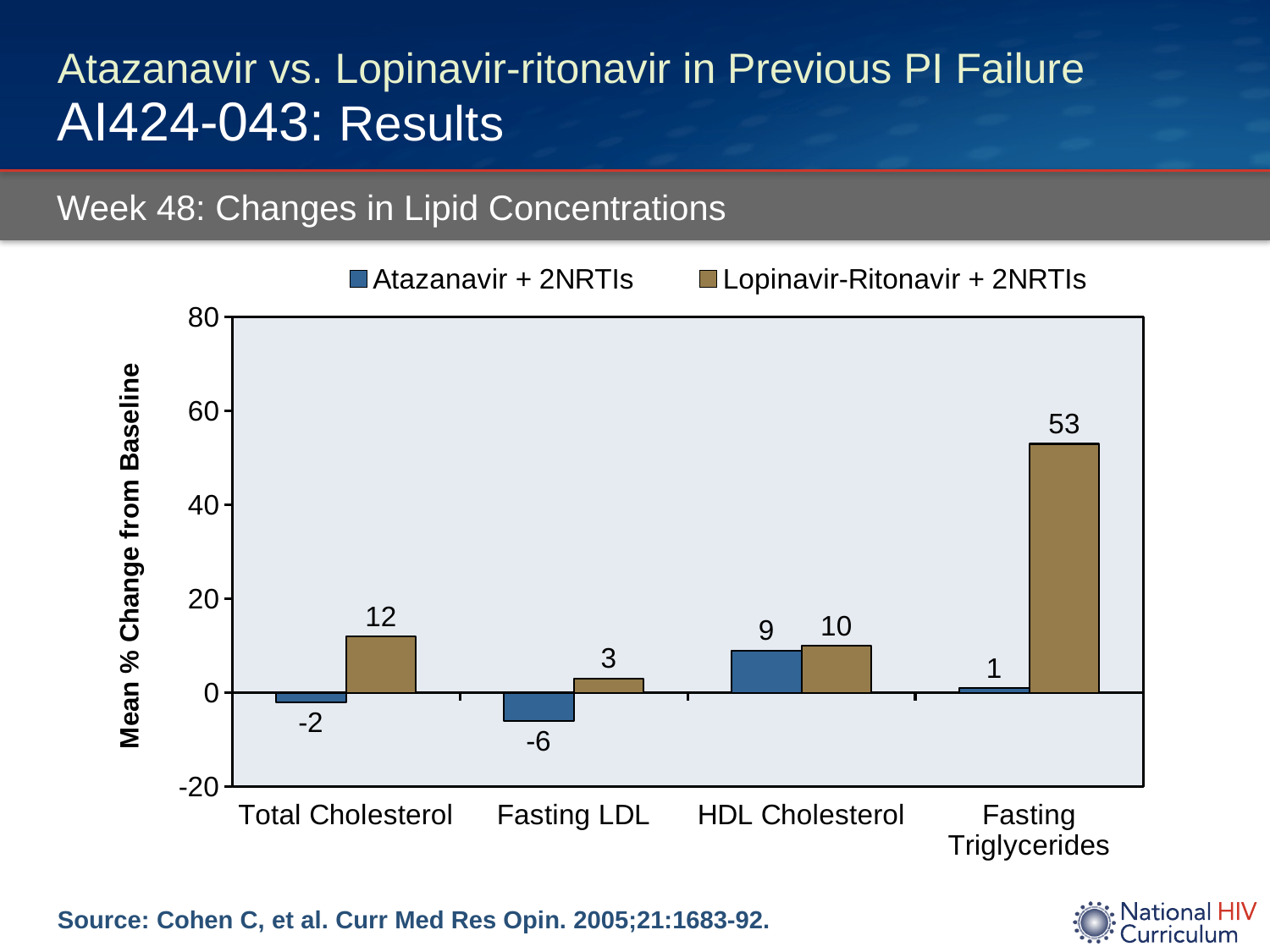
What is the mean % change from baseline in Fasting LDL for Atazanavir + 2NRTIs? -6 Which lipid category has the highest value for Lopinavir-Ritonavir + 2NRTIs? Fasting Triglycerides What type of chart is shown on the slide? Bar chart What is the difference between the Lopinavir-Ritonavir + 2NRTIs and Atazanavir + 2NRTIs values for Fasting Triglycerides? 52 What is the difference between the Lopinavir-Ritonavir + 2NRTIs and Atazanavir + 2NRTIs values for Total Cholesterol? 14 What is the mean % change from baseline in Total Cholesterol for Lopinavir-Ritonavir + 2NRTIs? 12 How many lipid categories are shown on the x axis? 4 Which lipid category has the lowest value for Atazanavir + 2NRTIs? Fasting LDL What is the mean % change from baseline in HDL Cholesterol for Atazanavir + 2NRTIs? 9 What is the mean % change from baseline in Fasting Triglycerides for Lopinavir-Ritonavir + 2NRTIs? 53 For Fasting LDL, which series has the larger value: Atazanavir + 2NRTIs or Lopinavir-Ritonavir + 2NRTIs? Lopinavir-Ritonavir + 2NRTIs How many series does the legend list? 2